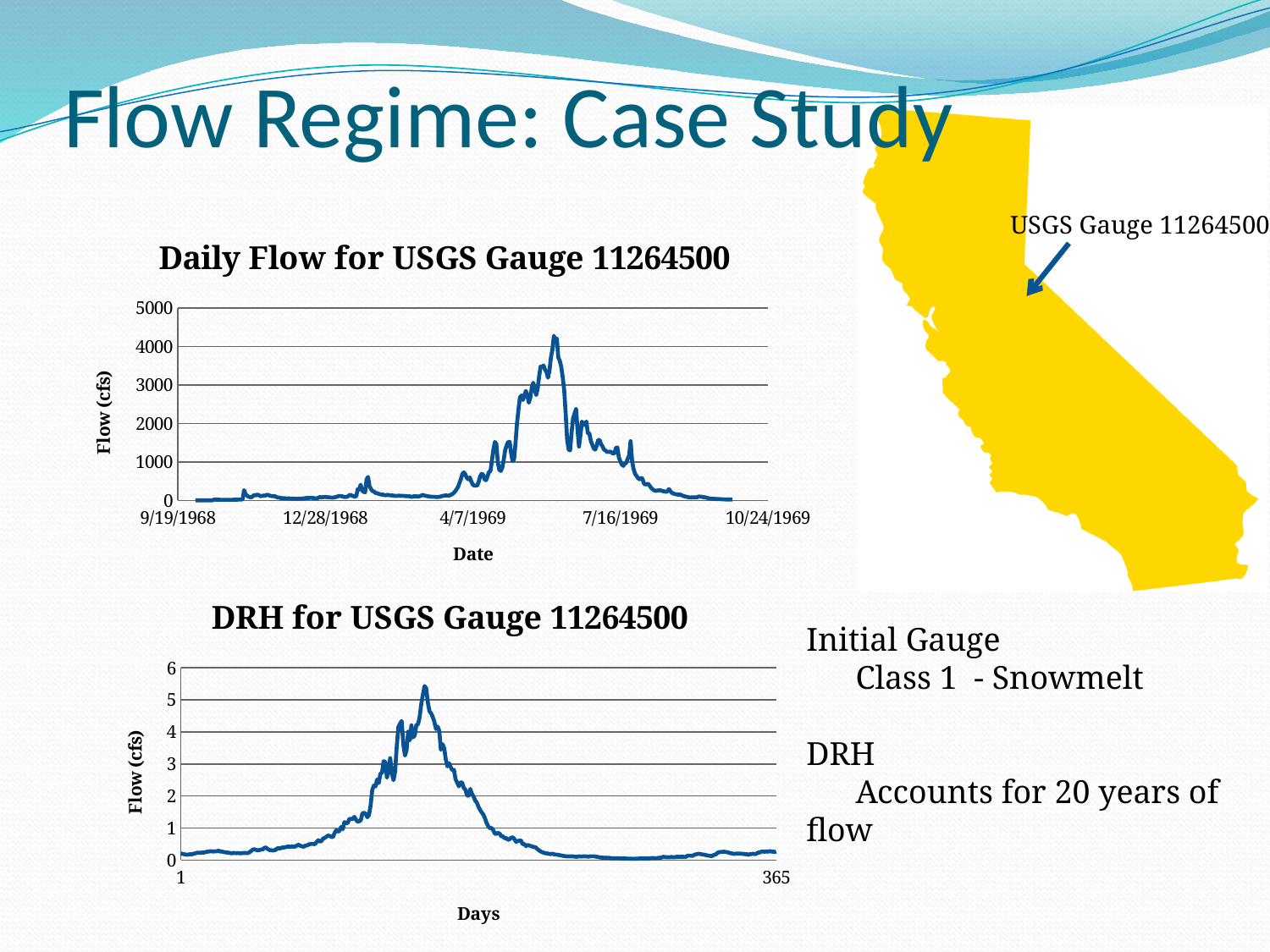
In the 'Daily Flow for USGS Gauge 11264500' chart, is the peak flow greater or less than 5000? less In the 'Daily Flow for USGS Gauge 11264500' chart, does the flow rise or fall between 7/16/1969 and 10/24/1969? fall In the 'DRH for USGS Gauge 11264500' chart, is the value at day 365 greater or less than 1? less In the 'DRH for USGS Gauge 11264500' chart, is the peak value greater or less than 6? less What kind of chart is the 'DRH for USGS Gauge 11264500' chart? line chart What is the x-axis label of the 'DRH for USGS Gauge 11264500' chart? Days What is the y-axis label of the 'Daily Flow for USGS Gauge 11264500' chart? Flow (cfs) In the 'DRH for USGS Gauge 11264500' chart, does the value rise or fall after the peak toward day 365? fall What kind of chart is the 'Daily Flow for USGS Gauge 11264500' chart? line chart